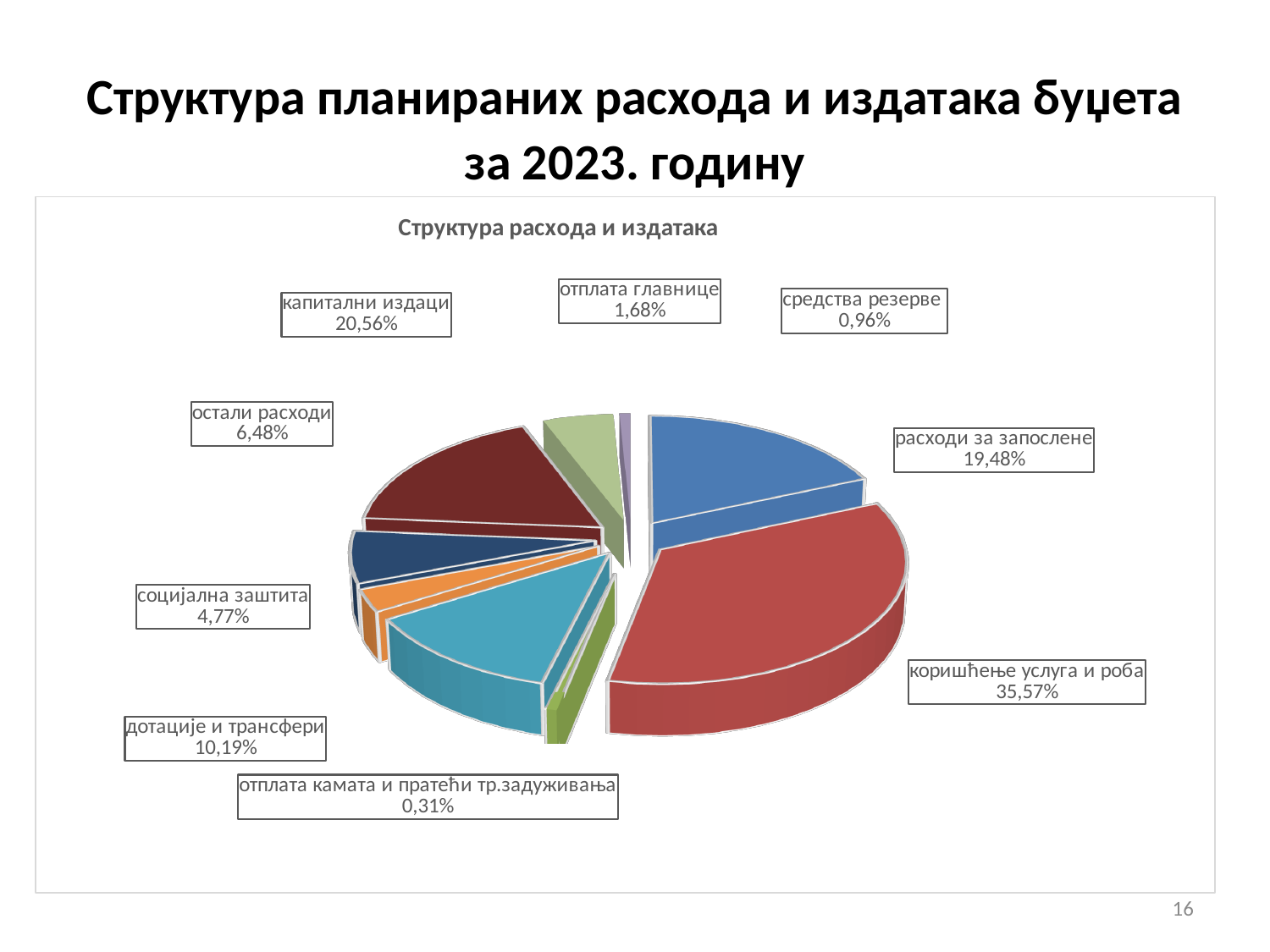
What is the value shown for социјална заштита? 4,77% What is the value shown for расходи за запослене? 19,48% What share of the pie does коришћење услуга и роба represent? 35,57% Which category has the largest share of the pie? коришћење услуга и роба What type of chart is shown on the slide? pie chart What is the value shown for дотације и трансфери? 10,19% How many categories are shown in the pie chart? 9 What is the title of the chart? Структура расхода и издатака What is the difference in percentage points between коришћење услуга и роба and расходи за запослене? 16,09 Which is larger, капитални издаци or расходи за запослене? капитални издаци What is the value shown for капитални издаци? 20,56% Which category has the smallest share of the pie? отплата камата и пратећи тр.задуживања